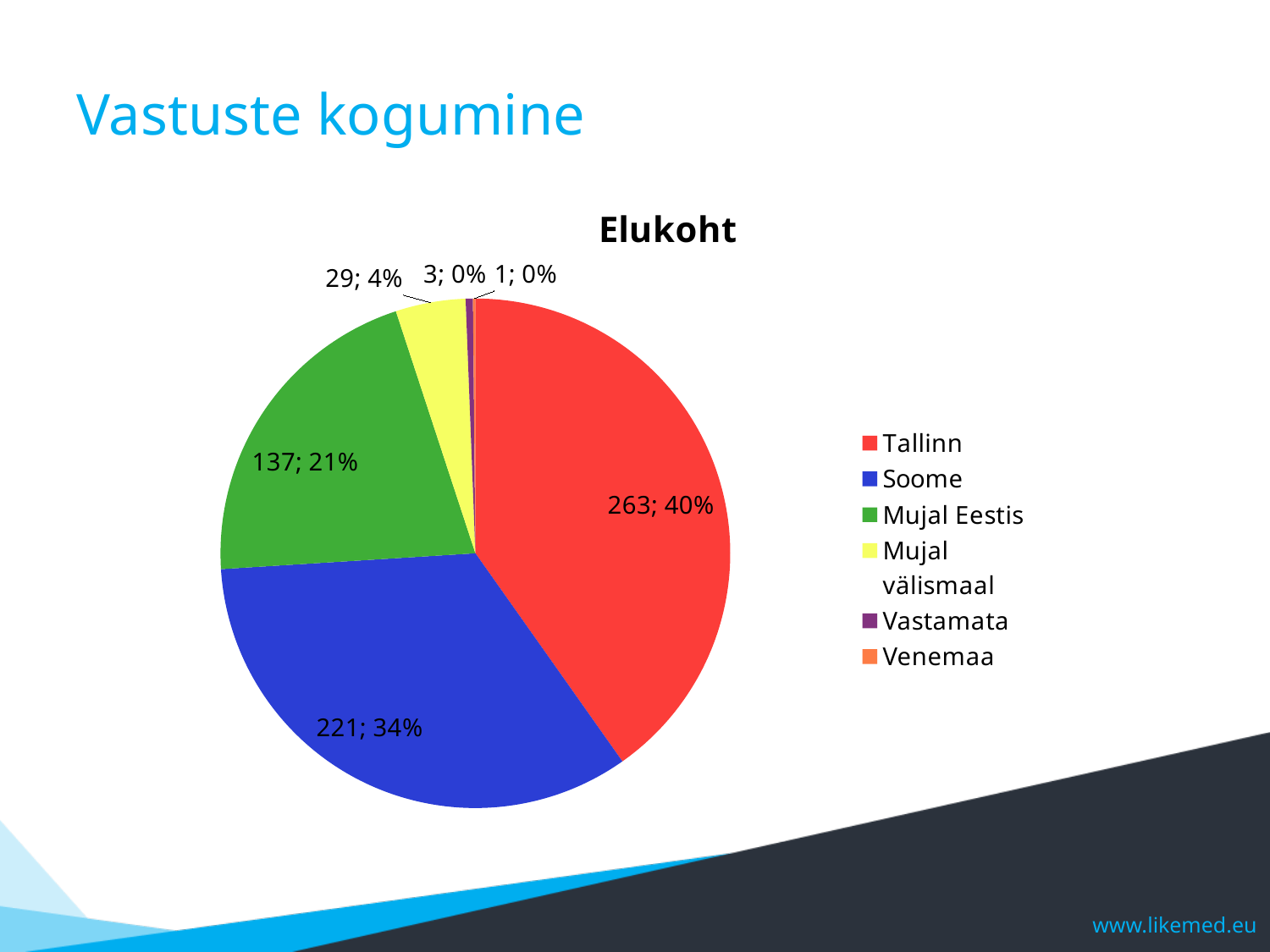
Which category has the largest slice of the pie? Tallinn How many categories does the legend of the pie chart list? 6 What percentage share does Mujal välismaal have? 4% What is the count shown for Tallinn in the pie chart? 263 What is the difference between the counts for Tallinn and Soome? 42 What type of chart is shown on the slide? pie chart What percentage share does Soome have in the pie chart? 34% What is the count shown for Mujal Eestis? 137 Which is larger, the count for Soome or the count for Mujal Eestis? Soome What colour is the slice for Mujal Eestis? green What is the title of the chart? Elukoht Which category has the smallest slice of the pie? Venemaa